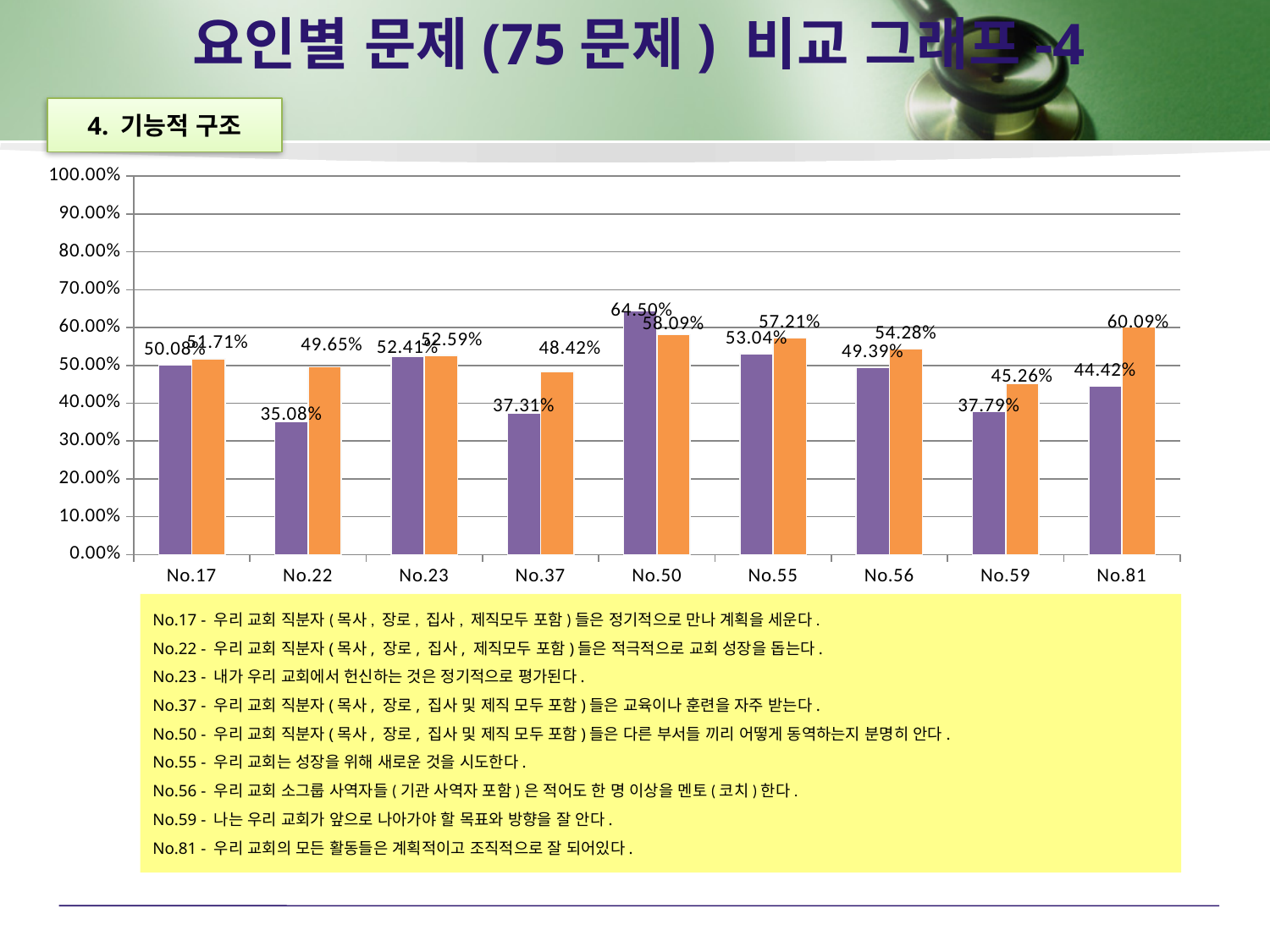
What is the value of the orange bar for No.81? 60.09% Which category has the lowest purple bar? No.22 What is the value of the orange bar for No.37? 48.42% Which category has the highest orange bar? No.81 What kind of chart is shown on the slide? bar chart For No.50, which bar is larger, the purple or the orange? purple Which category has the highest purple bar? No.50 How many categories are shown on the x axis? 9 Which category has the lowest orange bar? No.59 What is the difference between the orange bar and the purple bar for No.22? 14.57% What is the value of the purple bar for No.59? 37.79% What is the value of the purple bar for No.22? 35.08%